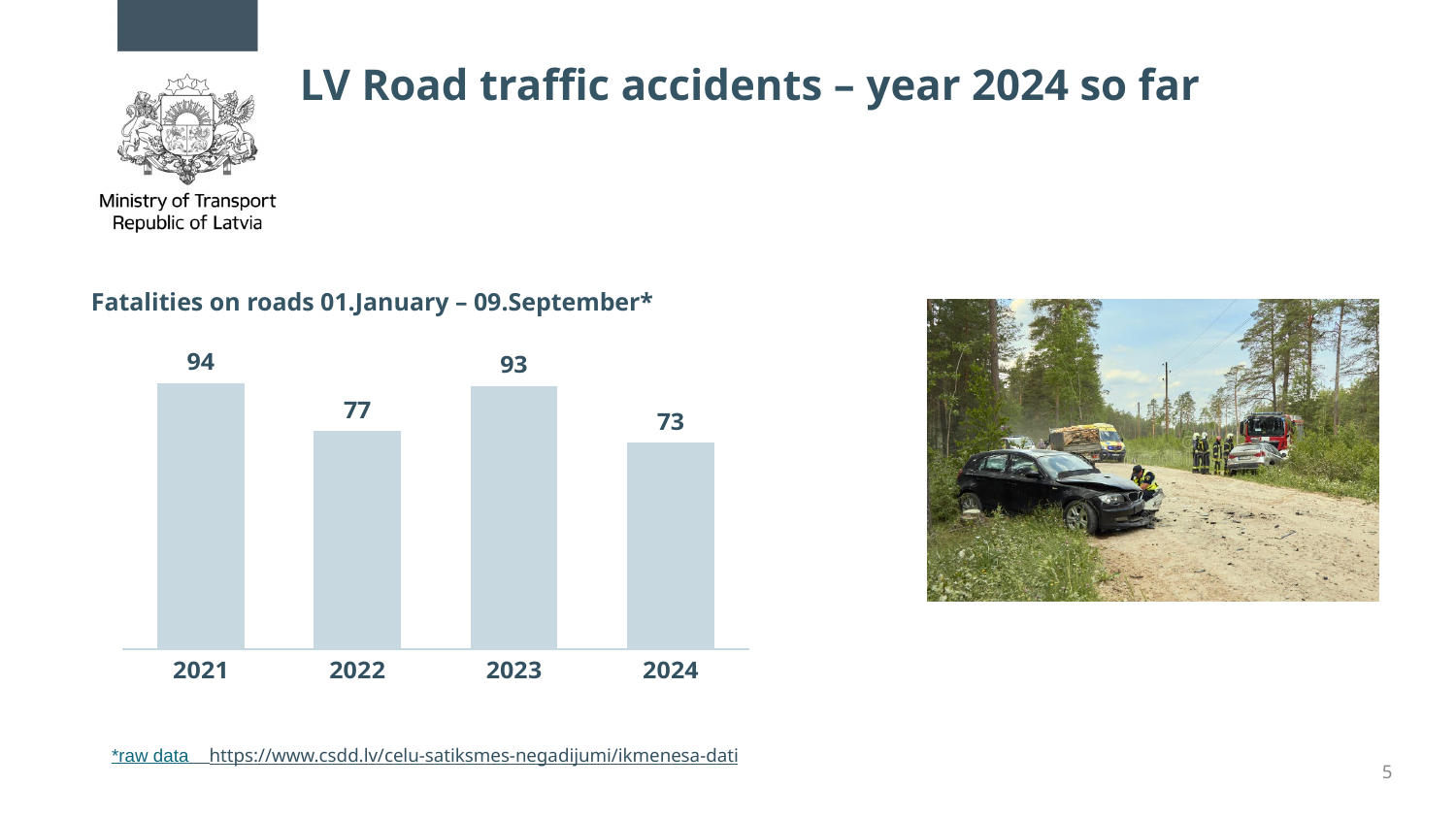
What is the difference in fatalities between 2021 and 2022? 17 What is the number of fatalities shown for 2024? 73 What is the difference in fatalities between 2023 and 2024? 20 Which year had more fatalities, 2022 or 2023? 2023 What is the total number of fatalities across all four years shown? 337 What is the number of fatalities shown for 2022? 77 What is the number of fatalities shown for 2021? 94 Which year has the lowest number of fatalities? 2024 What type of chart is used to show the fatalities? Bar chart Which year has the highest number of fatalities? 2021 What is the title of the chart? Fatalities on roads 01.January – 09.September* How many years are shown on the chart? 4